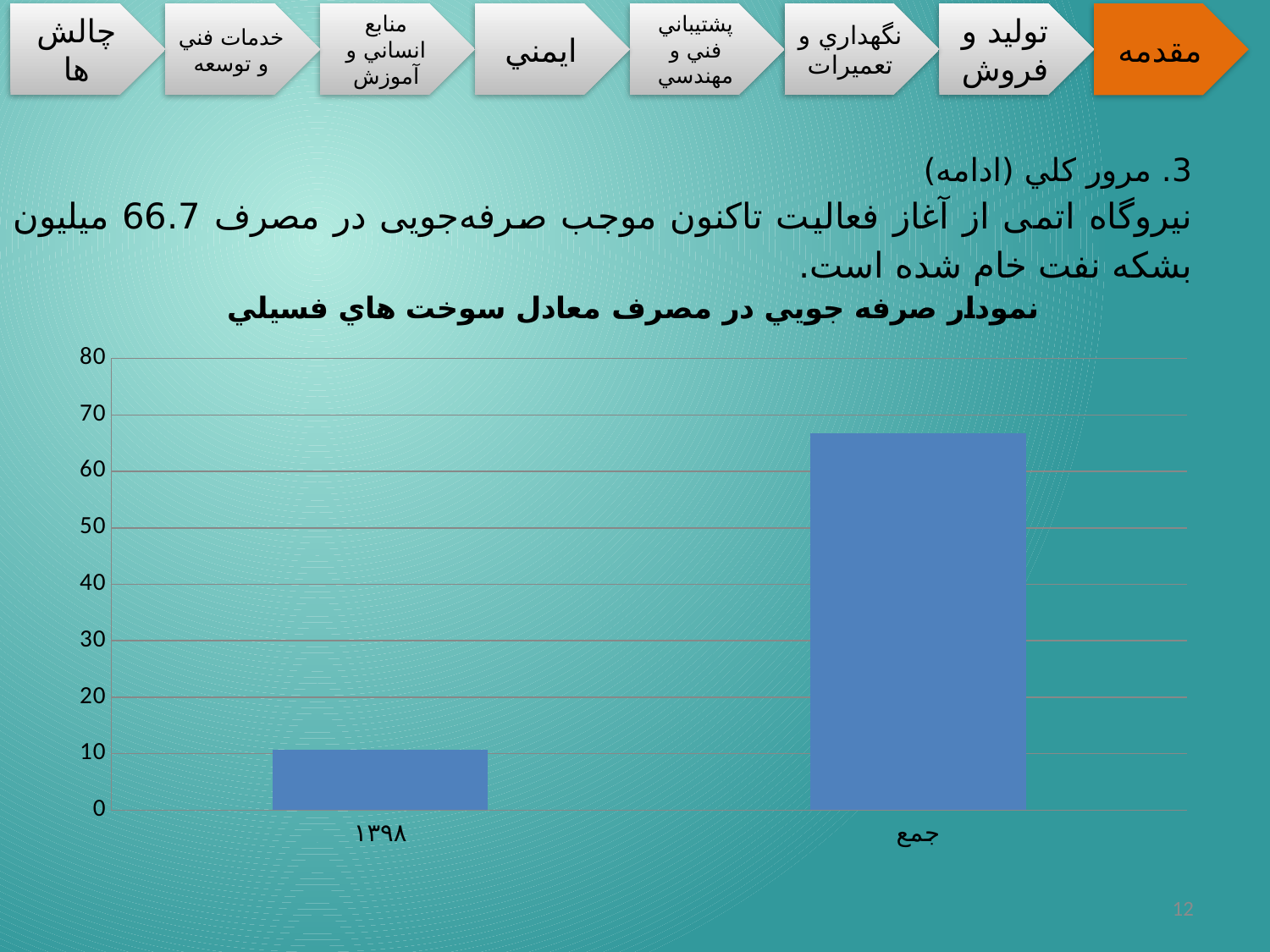
What is the highest value shown on the vertical axis of the chart? 80 Is the value for جمع greater or less than 60? greater Is the value for ۱۳۹۸ greater or less than 30? less Which category has the lowest value in the chart? ۱۳۹۸ Which is larger, the value for ۱۳۹۸ or the value for جمع? جمع Is the value for جمع greater or less than 70? less Do the bar values rise or fall from left to right across the chart? rise How many bars (categories) does the chart show? 2 What kind of chart is shown on the slide? bar chart Which category has the highest value in the chart? جمع What is the title of the chart? نمودار صرفه جويي در مصرف معادل سوخت هاي فسيلي